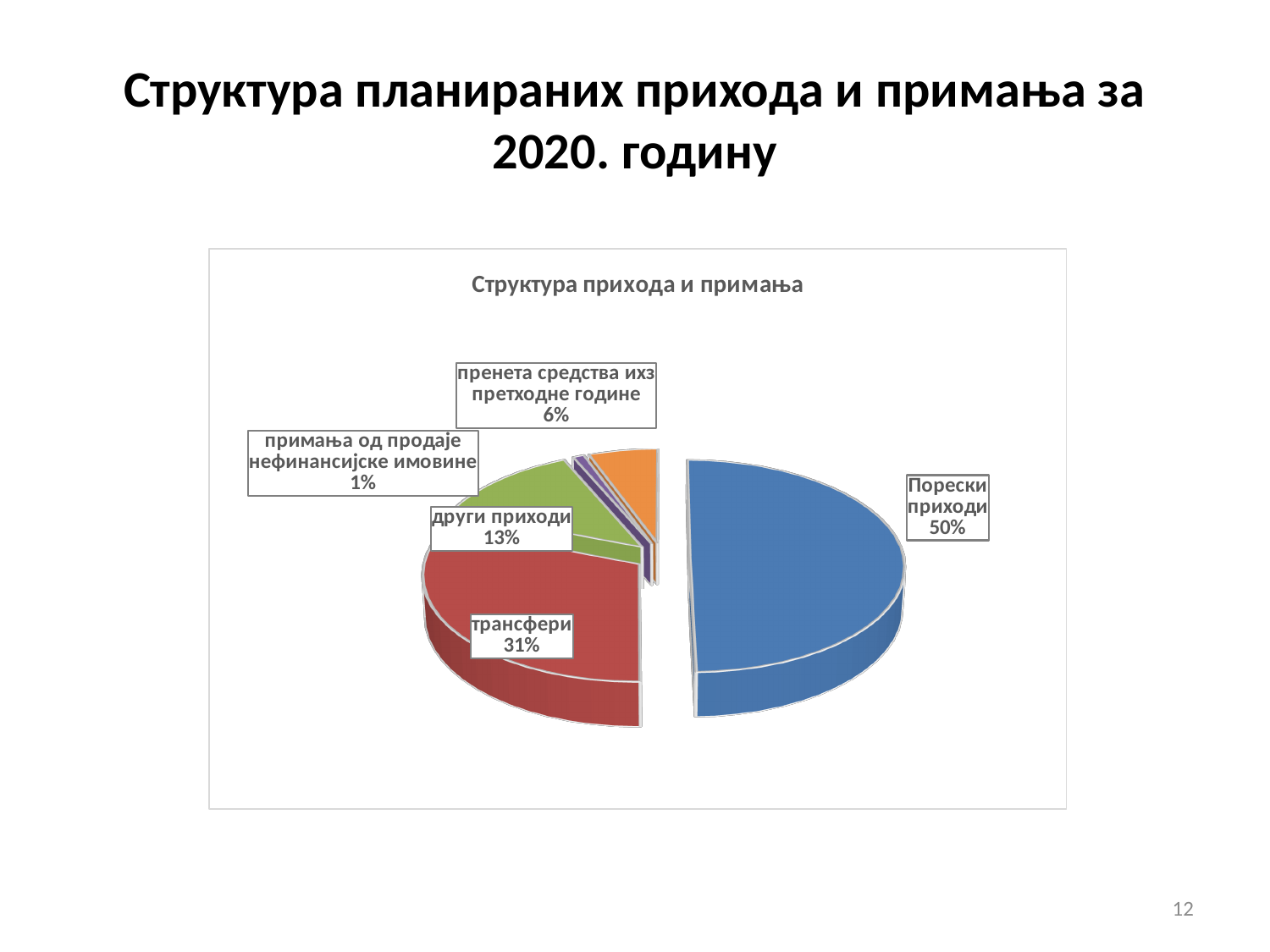
Which category has the smallest share of the pie? примања од продаје нефинансијске имовине How many slices does the pie chart have? 5 What is the difference in percentage points between Порески приходи and трансфери? 19 Which category has the largest share of the pie? Порески приходи What share of the pie is Порески приходи? 50% Which is larger, the share for други приходи or the share for пренета средства ихз претходне године? други приходи What kind of chart is shown on the slide? Pie chart What share of the pie is други приходи? 13% What share of the pie is примања од продаје нефинансијске имовине? 1% What is the chart's title? Структура прихода и примања